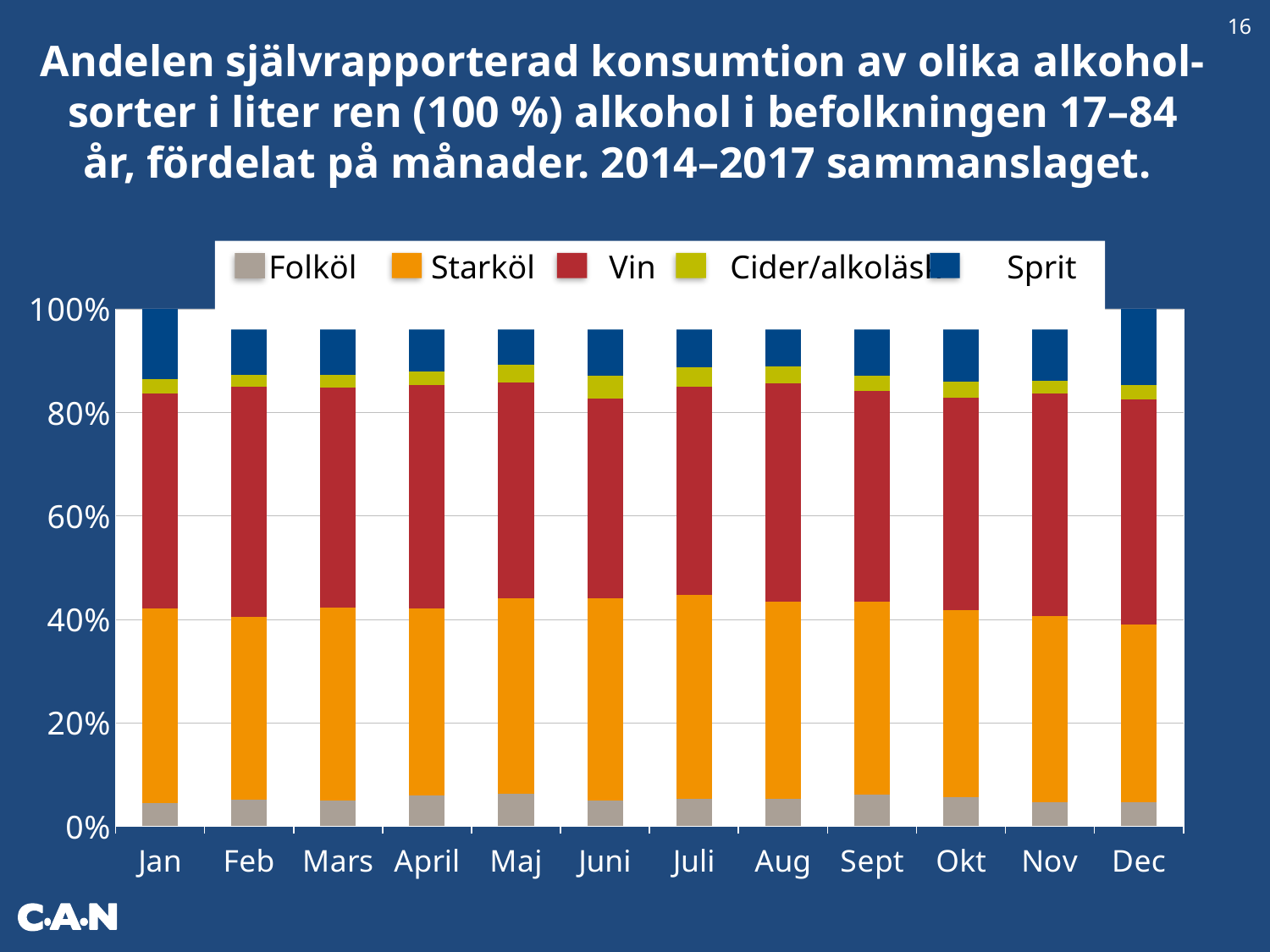
How many months are shown along the x axis of the chart? 12 Is the top of the Starköl segment for Sept greater or less than 60%? less How many series does the chart's legend list? 5 Is the top of the Vin segment for Jan greater or less than 80%? greater Which series is shown in orange in the chart? Starköl What is the total height of the stacked bar for Jan? 100% Is the top of the Starköl segment for Jan greater or less than 40%? greater What kind of chart is shown on the slide? stacked bar chart Which series is shown in dark blue at the top of each bar? Sprit